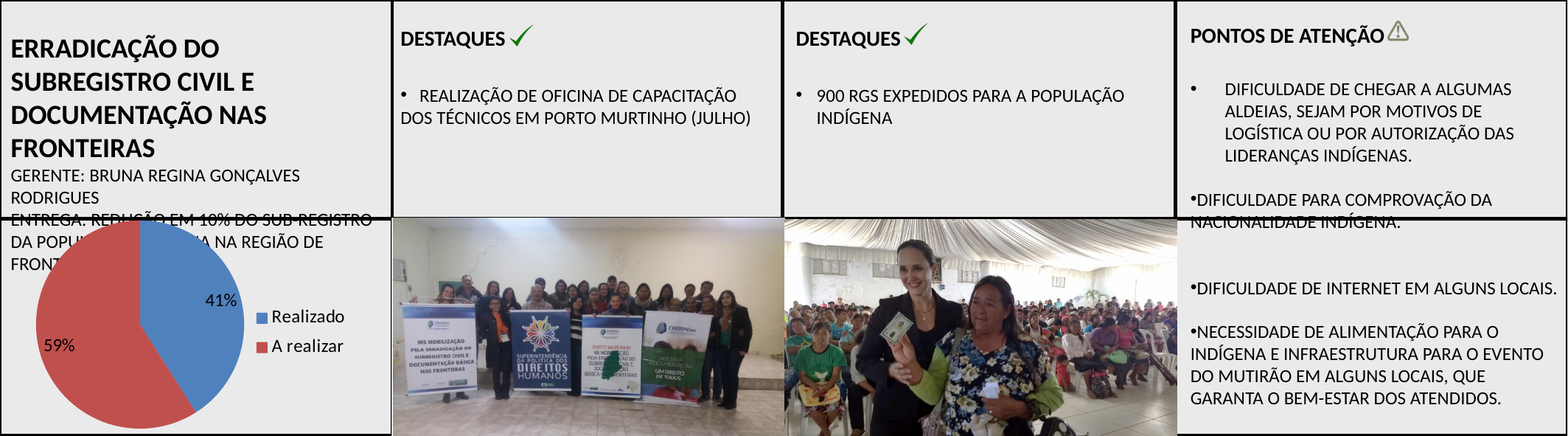
Which slice of the pie chart is the largest? A realizar What kind of chart is shown on the slide? pie chart How many entries does the legend of the pie chart list? 2 Which slice of the pie chart is the smallest? Realizado What colour is the "A realizar" slice in the pie chart? red What share of the pie does the "Realizado" slice represent? 41% Which is larger in the pie chart, "Realizado" or "A realizar"? A realizar How many slices does the pie chart have? 2 What is the difference between the "A realizar" and "Realizado" shares in the pie chart? 18% What is the value for "A realizar" in the pie chart? 59% What is the value for "Realizado" in the pie chart? 41% What colour is the "Realizado" slice in the pie chart? blue